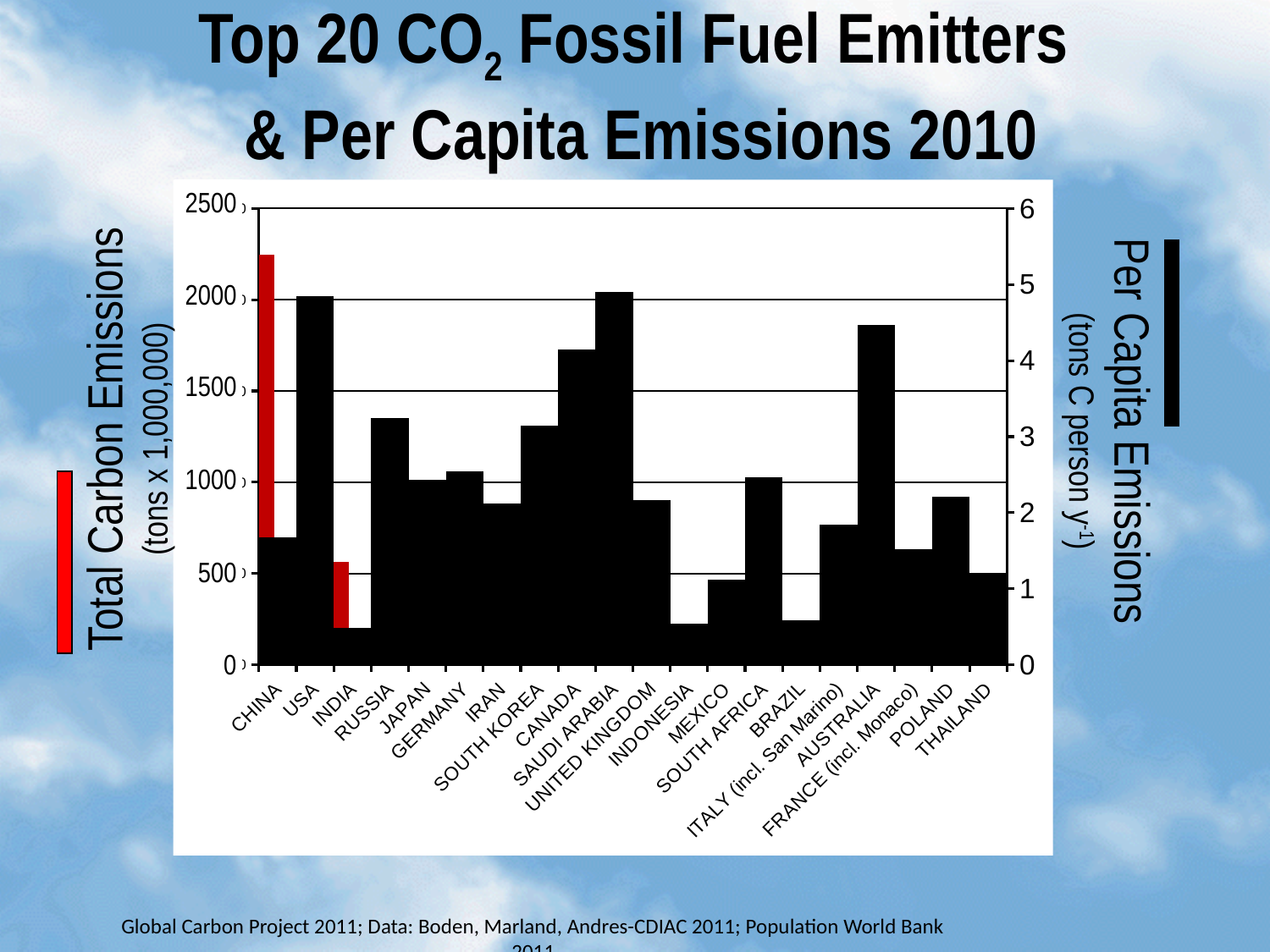
Which has the higher Total Carbon Emissions value, CHINA or INDIA? CHINA How many countries are shown along the x axis of the chart? 20 Is the Per Capita Emissions value for AUSTRALIA greater or less than 4? greater Is the Per Capita Emissions value for INDONESIA greater or less than 1? less Is the Total Carbon Emissions value for INDIA greater or less than 1000? less Which has the higher Per Capita Emissions value, CANADA or JAPAN? CANADA What kind of chart is shown on the slide? bar chart How many series does the chart's legend list? 2 Which has the higher Per Capita Emissions value, RUSSIA or MEXICO? RUSSIA What colour are the Total Carbon Emissions bars in the chart? red